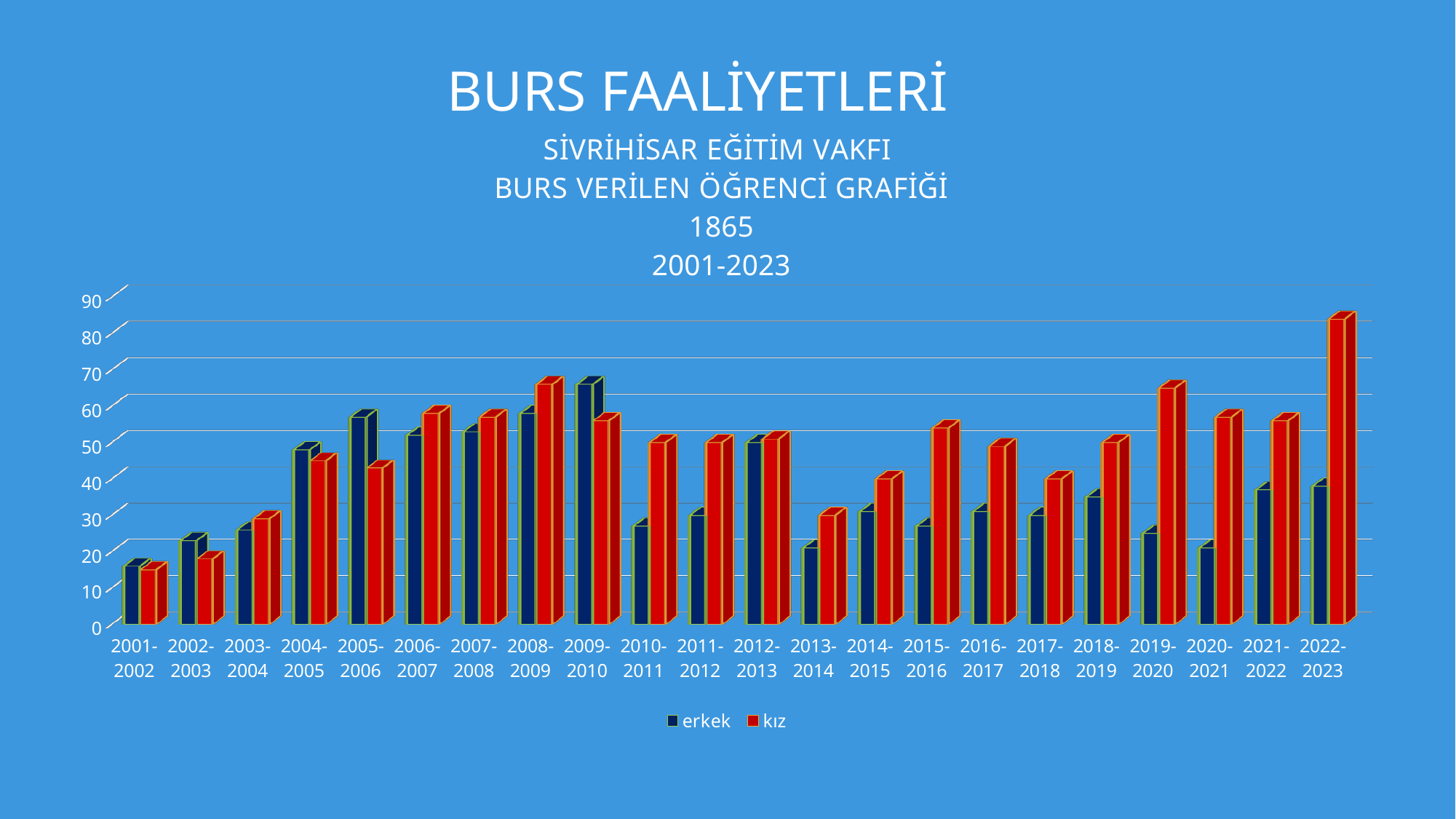
Is the erkek value for 2001-2002 greater or less than 20? less For 2010-2011, which is larger, the erkek value or the kız value? kız In which academic year is the erkek value lowest? 2001-2002 How many academic-year categories are shown on the x axis? 22 How many series does the legend list? 2 Is the kız value for 2019-2020 greater or less than 60? greater In which academic year is the erkek value highest? 2009-2010 For 2005-2006, which is larger, the erkek value or the kız value? erkek Which colour represents the kız series in the legend? red In which academic year is the kız value highest? 2022-2023 What kind of chart is shown on the slide? bar chart Is the kız value for 2022-2023 greater or less than 80? greater